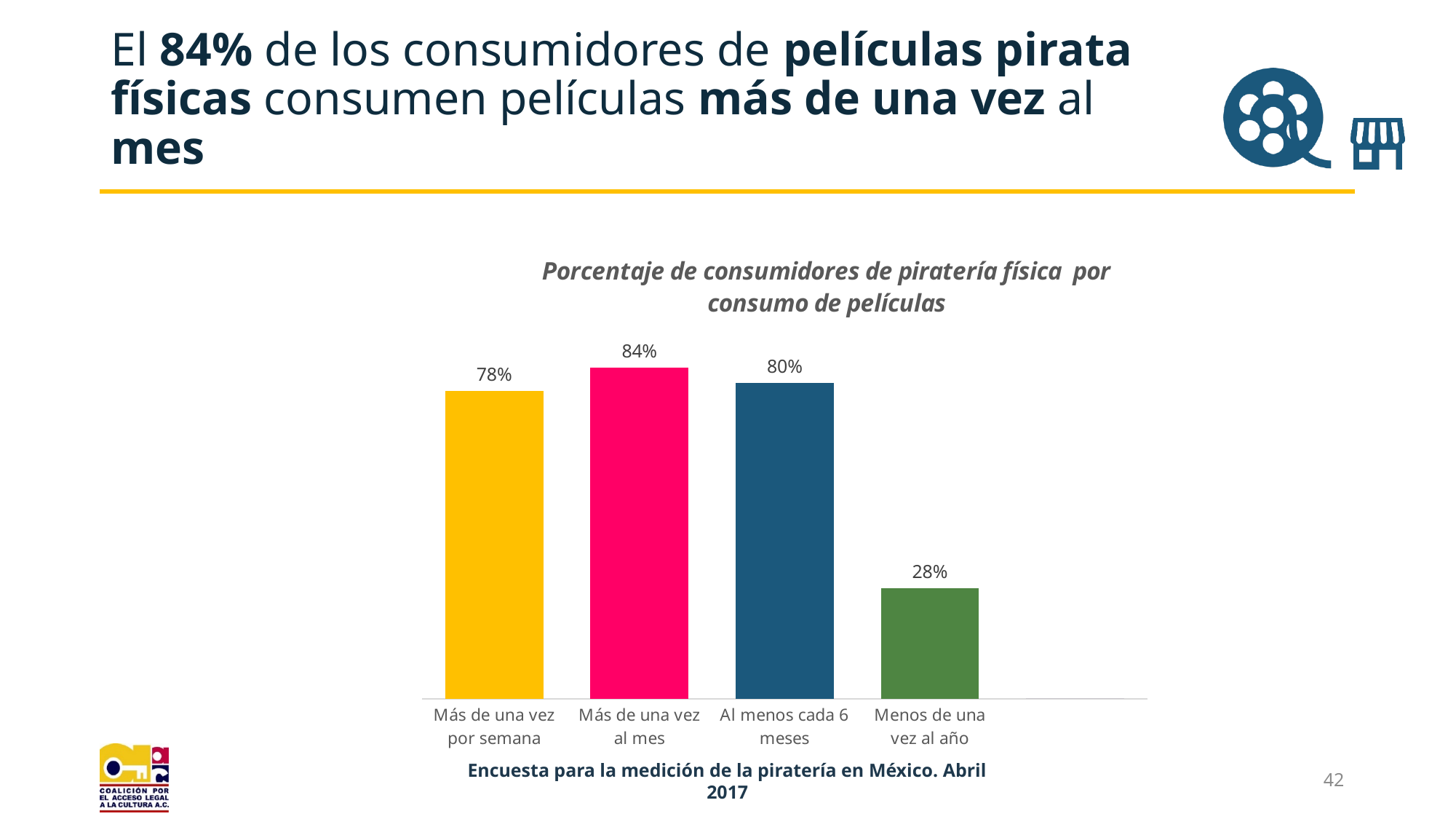
Which category has the lowest value? Menos de una vez al año Which category has the highest value? Más de una vez al mes What is the value for "Menos de una vez al año"? 28% Which is larger, the value for "Más de una vez por semana" or the value for "Menos de una vez al año"? Más de una vez por semana What is the value for "Más de una vez por semana"? 78% What is the difference between the values for "Más de una vez al mes" and "Menos de una vez al año"? 56% What kind of chart is shown on the slide? Bar chart What is the difference between the values for "Al menos cada 6 meses" and "Más de una vez por semana"? 2% What is the title of the chart? Porcentaje de consumidores de piratería física por consumo de películas What is the value for "Más de una vez al mes"? 84% What is the value for "Al menos cada 6 meses"? 80% How many categories are shown in the chart? 4